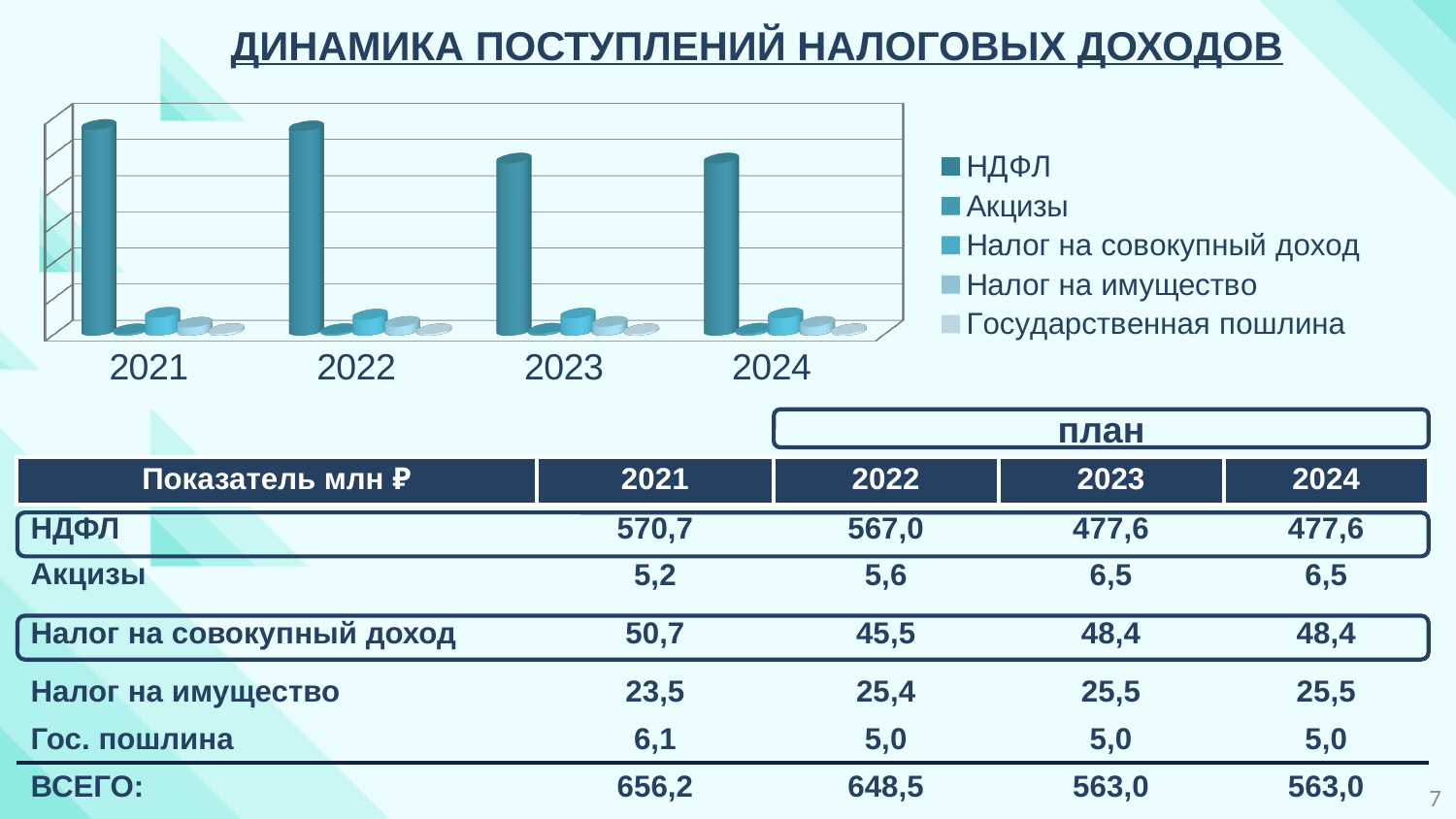
How many series does the chart legend list? 5 What is the total (ВСЕГО) of all tax revenues for 2021? 656,2 Which legend entry is listed last in the chart legend? Государственная пошлина What is the title of the slide's chart section? ДИНАМИКА ПОСТУПЛЕНИЙ НАЛОГОВЫХ ДОХОДОВ Do the НДФЛ values rise or fall from 2021 to 2024? fall What is the difference between the НДФЛ values for 2021 and 2023? 93,1 Which series has the tallest bars in every year of the chart? НДФЛ What is the value of НДФЛ for 2021 (млн ₽)? 570,7 Is the НДФЛ bar larger in 2021 or in 2023? 2021 What is the value of Налог на совокупный доход for 2022? 45,5 What kind of chart is shown on the slide? bar chart How many years are shown along the x axis of the chart? 4